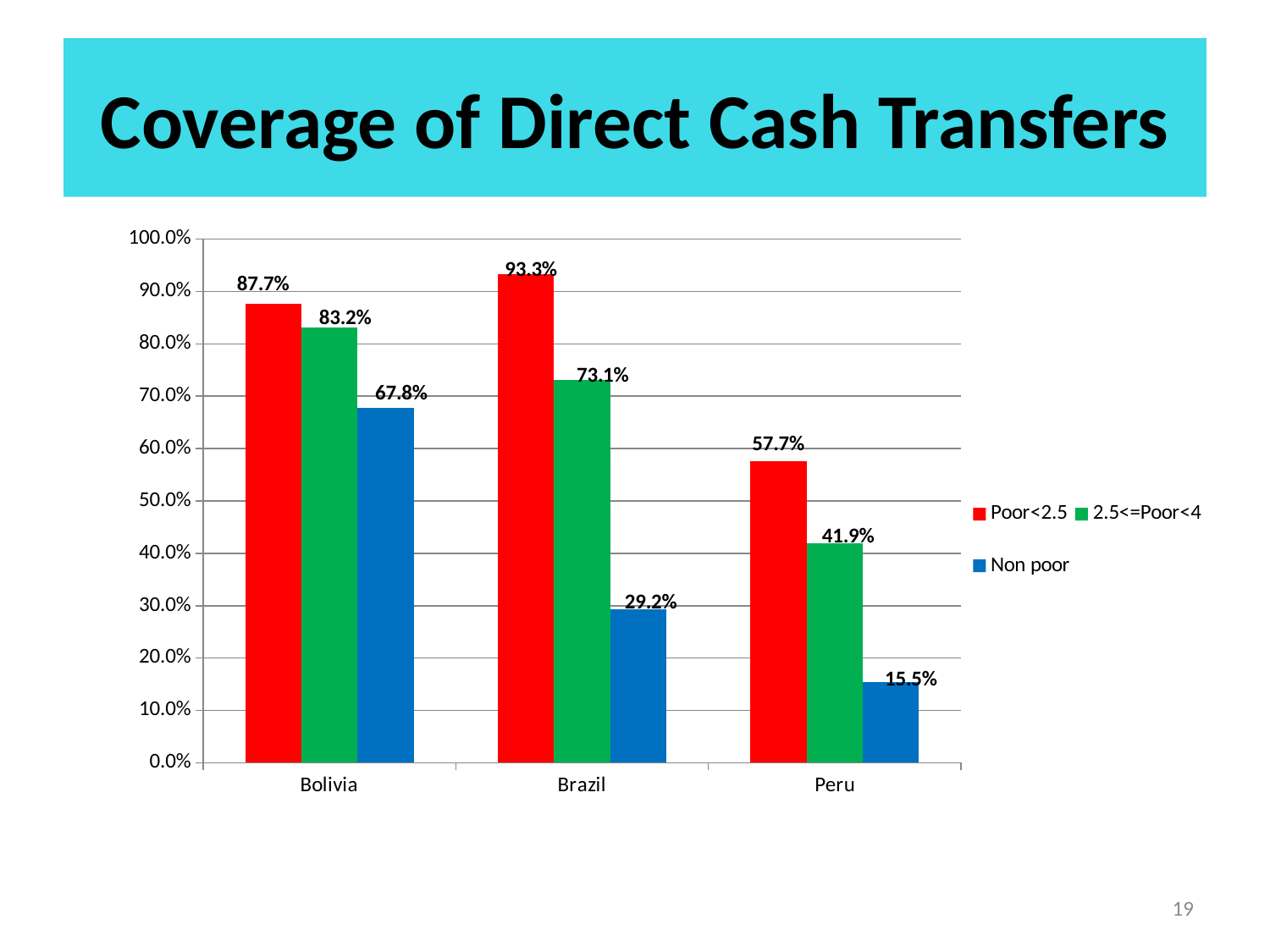
What kind of chart is shown on the slide? bar chart How many countries are shown on the x axis? 3 Which country has the highest value for Poor<2.5? Brazil Which is larger: the Non poor value in Bolivia or the 2.5<=Poor<4 value in Peru? Non poor value in Bolivia Which country has the lowest value for Non poor? Peru What is the difference between the Poor<2.5 and Non poor values in Brazil? 64.1% What is the value for Non poor in Peru? 15.5% What is the value for Poor<2.5 in Brazil? 93.3% What is the value for 2.5<=Poor<4 in Bolivia? 83.2% What is the title of the slide? Coverage of Direct Cash Transfers Is the value for 2.5<=Poor<4 in Brazil greater or less than 70.0%? greater How many series does the legend list? 3